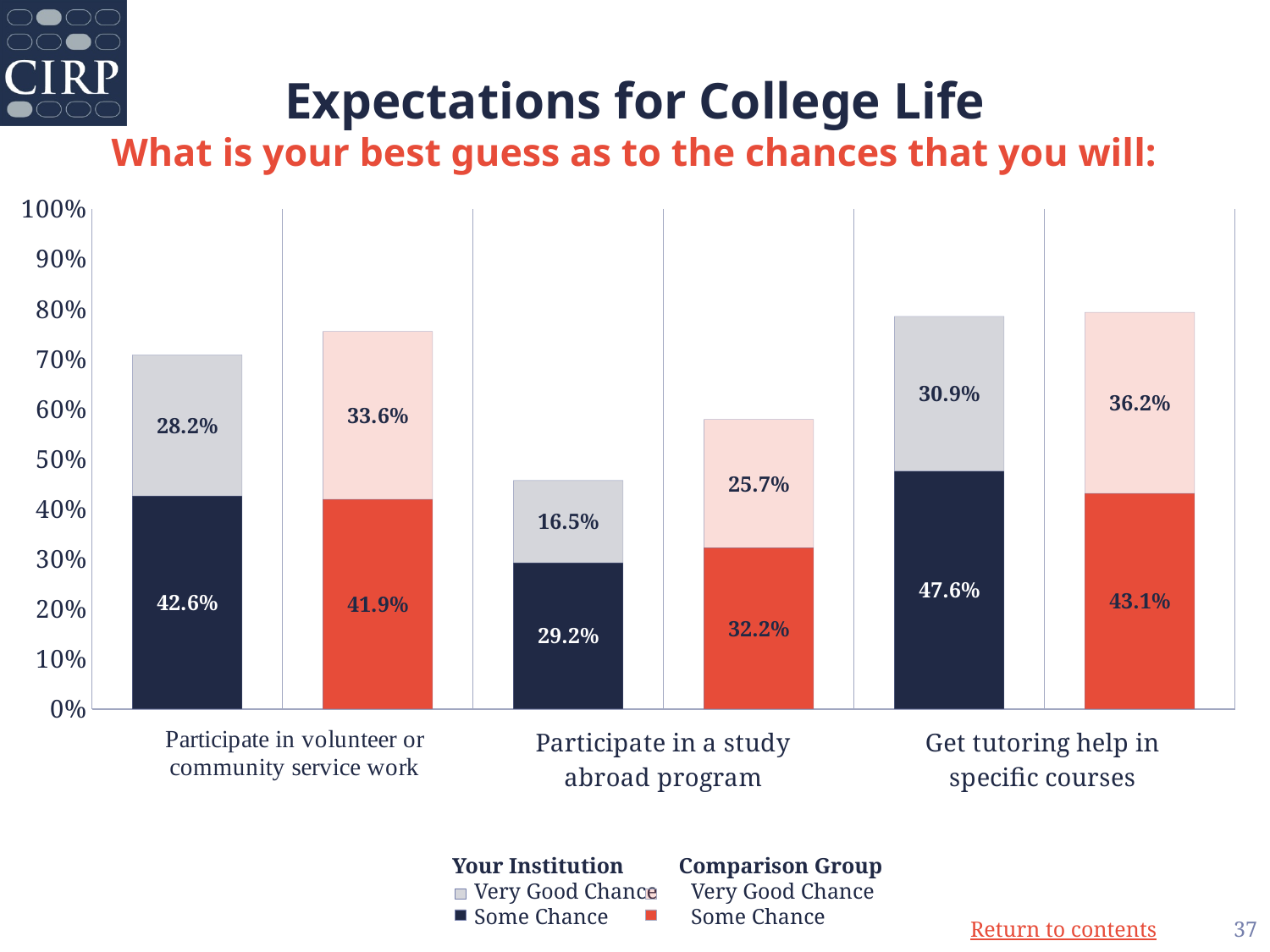
What is the Comparison Group 'Very Good Chance' value for getting tutoring help in specific courses? 36.2% Among the Your Institution 'Some Chance' values, which category is the highest? Get tutoring help in specific courses What is the total height of the Your Institution stacked bar for participating in a study abroad program? 45.7% How many series does the legend list? 4 How many categories are shown on the x axis of the chart? 3 What is the total height of the Comparison Group stacked bar for getting tutoring help in specific courses? 79.3% What percentage of Your Institution students said there is a 'Very Good Chance' they will participate in volunteer or community service work? 28.2% Among the Your Institution 'Very Good Chance' values, which category is the lowest? Participate in a study abroad program What is the difference between the Comparison Group and Your Institution 'Very Good Chance' values for participating in a study abroad program? 9.2% Which is larger for participating in volunteer or community service work: the Your Institution 'Some Chance' value or the Comparison Group 'Some Chance' value? Your Institution (42.6%) What is the Your Institution 'Some Chance' value for getting tutoring help in specific courses? 47.6% What is the Comparison Group 'Some Chance' value for participating in a study abroad program? 32.2%